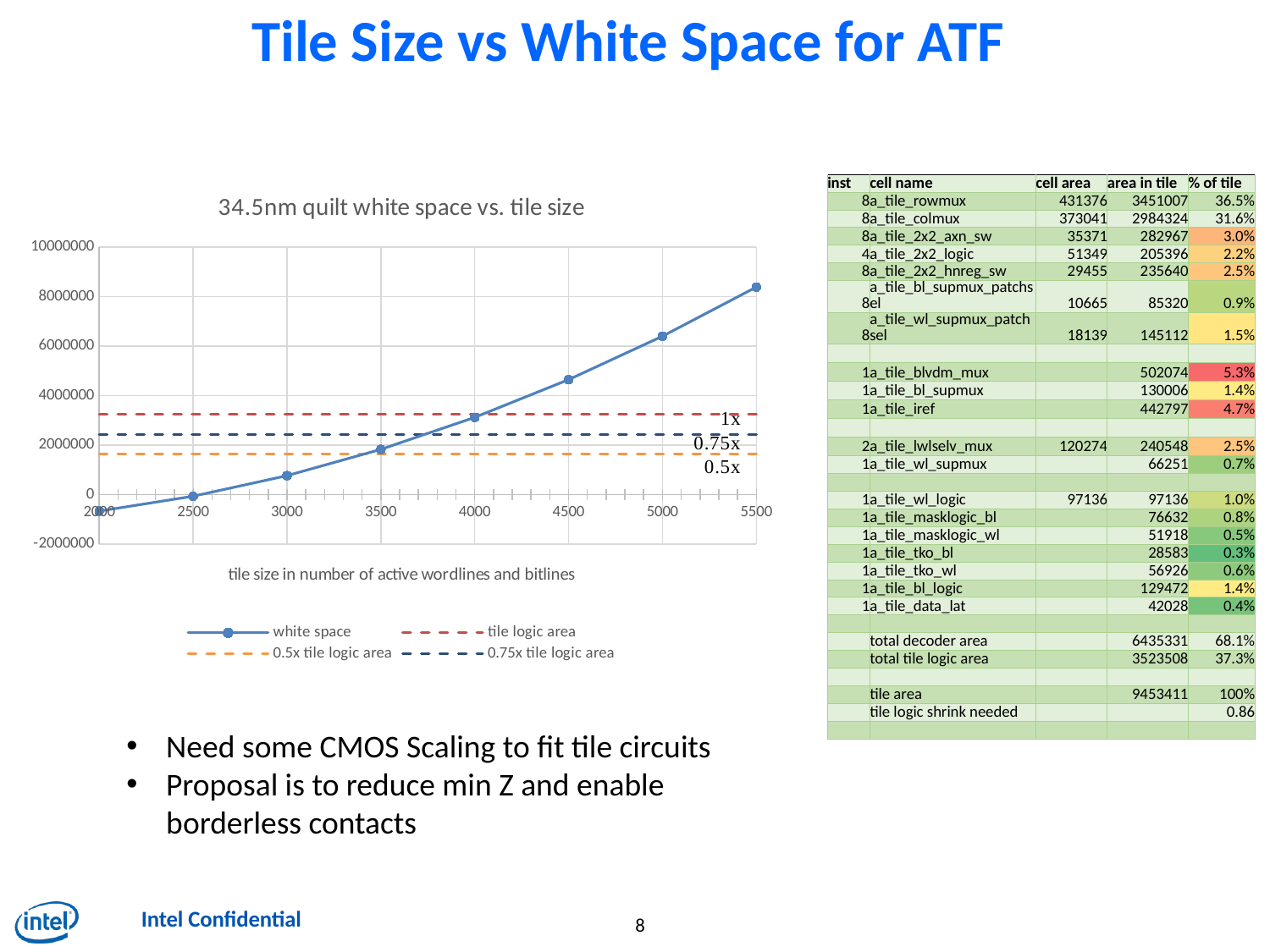
Is the white space value at tile size 5500 greater or less than 6000000? greater Is the white space value at tile size 3000 greater or less than 2000000? less Does the white space series rise or fall as tile size increases along the x axis? rises At which tile size is the white space value highest? 5500 Is the white space value at tile size 4000 greater or less than 2000000? greater What kind of chart is shown on the slide? line chart How many series does the chart legend list? 4 How many data points are plotted on the white space series? 8 What is the title of the chart? 34.5nm quilt white space vs. tile size At which tile size is the white space value lowest? 2000 Which is larger, the white space value at tile size 5000 or at tile size 3500? 5000